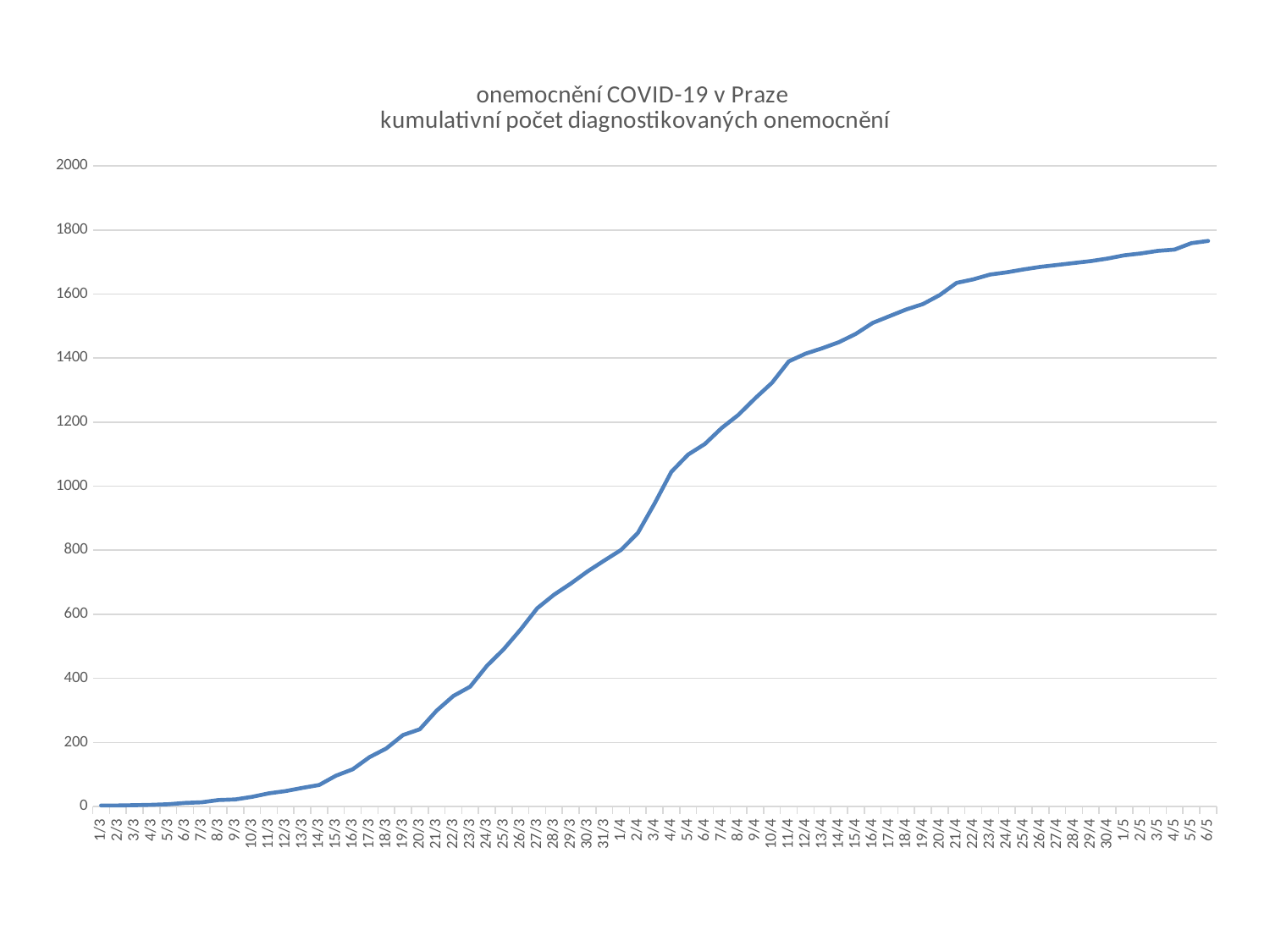
Is the value for 27/3 greater or less than 400? greater Is the value for 1/4 greater or less than 1000? less Which date has the larger value, 4/4 or 24/3? 4/4 Is the value for 15/3 greater or less than 200? less Do the values rise or fall along the x axis from 1/3 to 6/5? rise What is the title of the chart? onemocnění COVID-19 v Praze kumulativní počet diagnostikovaných onemocnění What kind of chart is shown on the slide? line chart On which date is the plotted value highest? 6/5